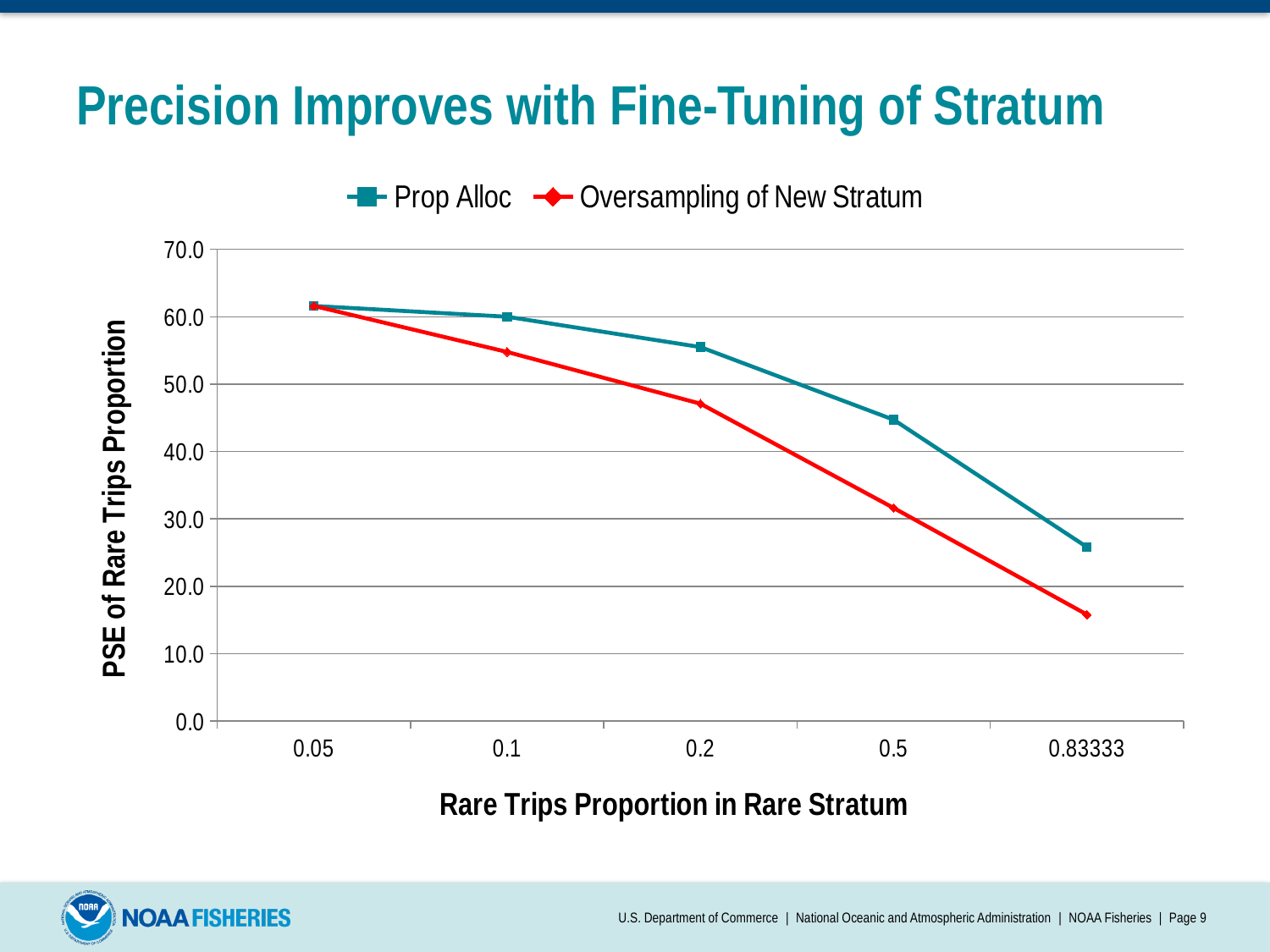
What is the title of the y axis? PSE of Rare Trips Proportion Do the Prop Alloc values rise or fall as the Rare Trips Proportion in Rare Stratum increases along the x axis? Fall Is the Oversampling of New Stratum value at 0.83333 greater or less than 20.0? less At which x-axis value is the Oversampling of New Stratum series lowest? 0.83333 How many series does the legend list? 2 Is the Oversampling of New Stratum value at 0.2 greater or less than 50.0? less Is the Prop Alloc value at 0.5 greater or less than 40.0? greater At 0.5 on the x axis, which series has the higher PSE value, Prop Alloc or Oversampling of New Stratum? Prop Alloc What kind of chart is shown on the slide? Line chart How many x-axis categories are plotted for each series? 5